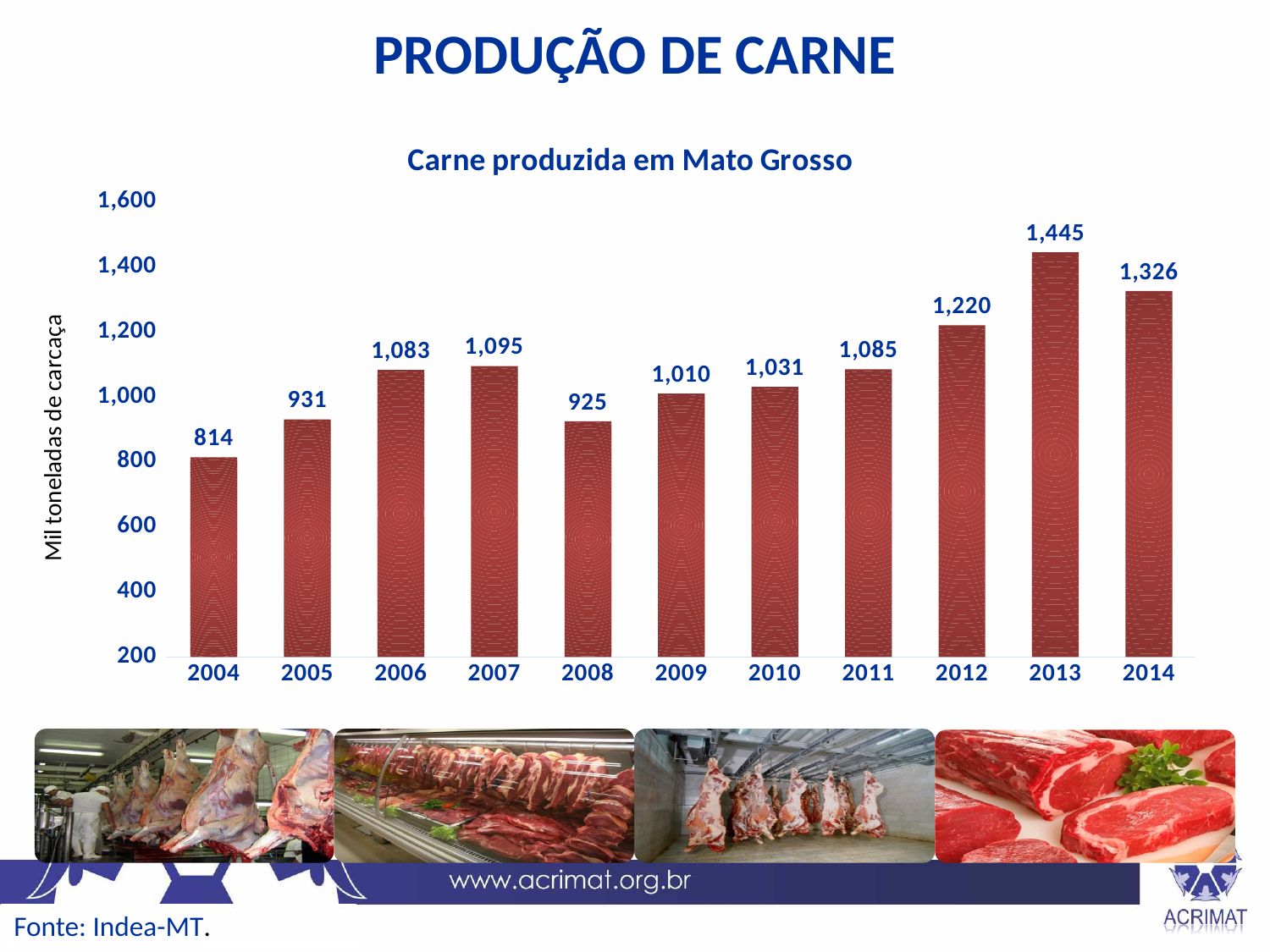
Which year has the lowest meat production? 2004 What kind of chart is shown on the slide? Bar chart Which year has the highest meat production? 2013 What is the title of the chart? Carne produzida em Mato Grosso What value is shown for 2008? 925 How many years are shown on the x axis? 11 What value is shown for 2013? 1,445 Which is larger, the value for 2007 or the value for 2009? 2007 What is the difference between the values for 2012 and 2011? 135 What is the difference between the values for 2013 and 2014? 119 What was the meat production in Mato Grosso in 2004? 814 Is the value for 2012 greater or less than 1,200? greater